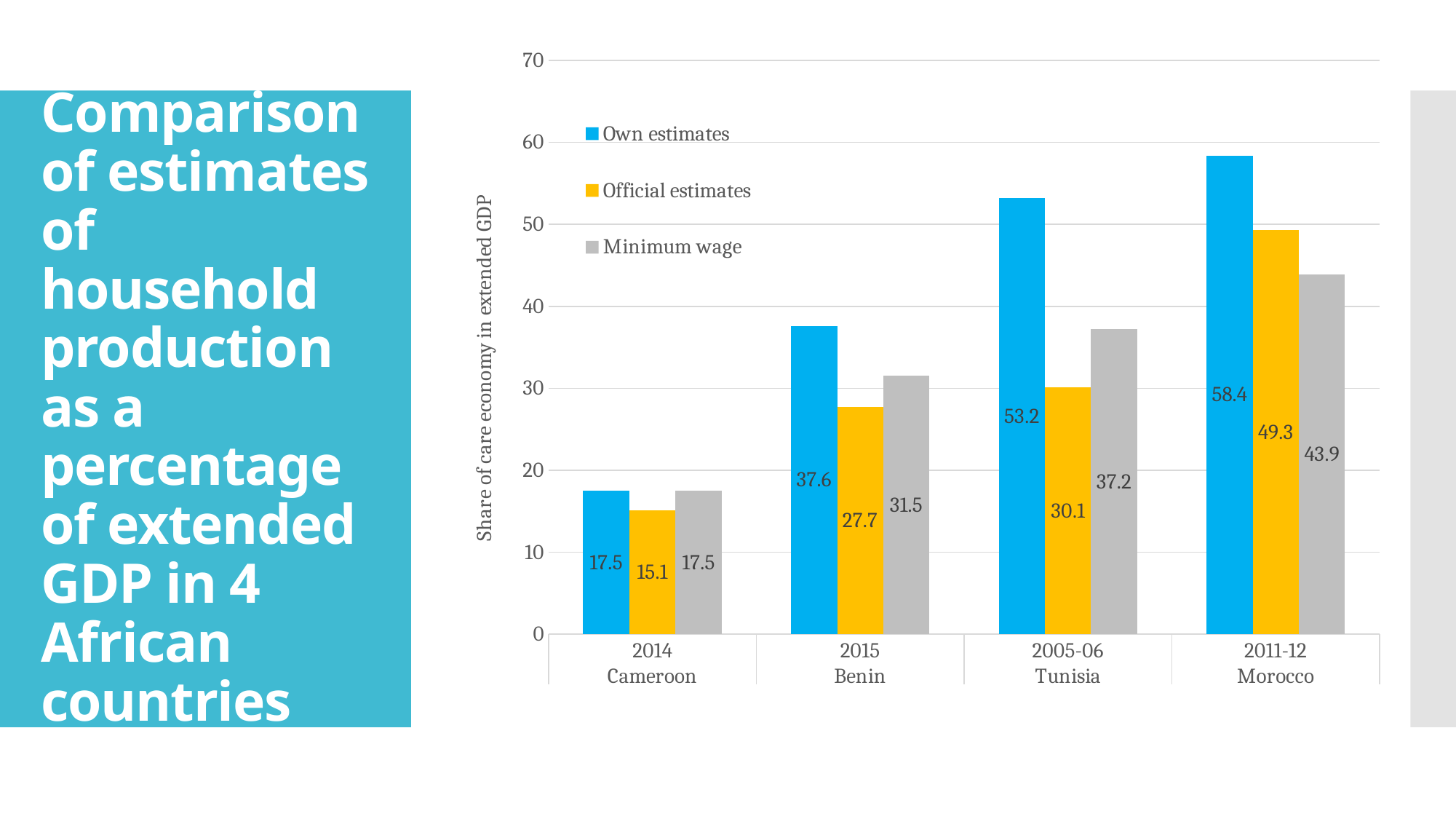
What is the Minimum wage value for Tunisia (2005-06)? 37.2 What kind of chart is shown on the slide? bar chart Which is larger for Benin: the Official estimates value or the Minimum wage value? Minimum wage What is the Own estimates value for Morocco (2011-12)? 58.4 Which country has the lowest Official estimates value? Cameroon Which country has the highest Own estimates value? Morocco How many countries are shown on the x axis? 4 Is the Own estimates value for Tunisia greater or less than 50? greater What is the Official estimates value for Benin (2015)? 27.7 How many series does the legend list? 3 What is the difference between the Own estimates and Official estimates values for Tunisia? 23.1 What is the label of the vertical axis? Share of care economy in extended GDP